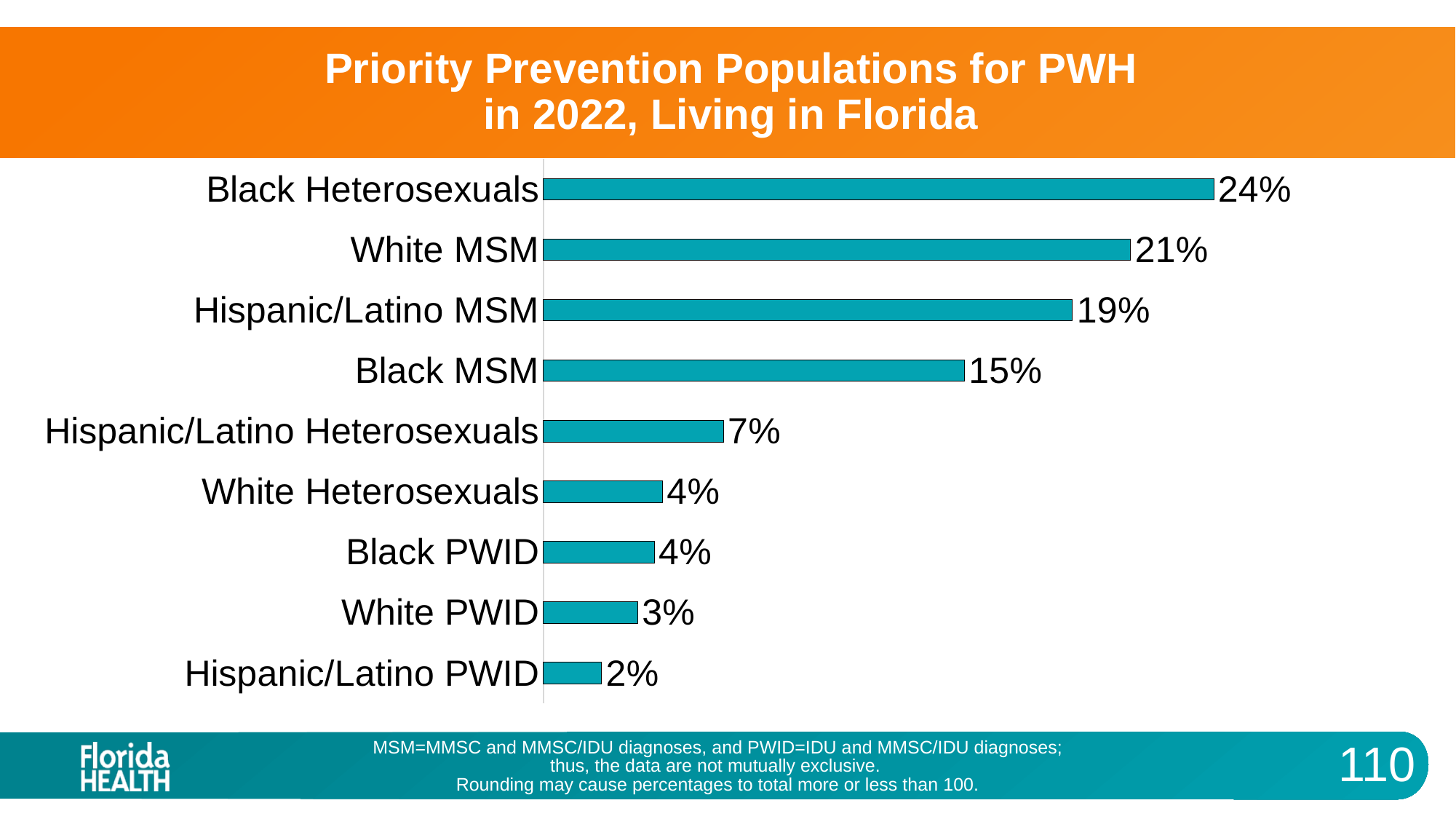
What percentage is shown for Black Heterosexuals? 24% What percentage is shown for White PWID? 3% Which population has the highest percentage? Black Heterosexuals What percentage is shown for Hispanic/Latino MSM? 19% What is the difference between the percentages for Black Heterosexuals and Hispanic/Latino Heterosexuals? 17% How many populations are shown in the chart? 9 Which is larger, the percentage for Hispanic/Latino MSM or for Black MSM? Hispanic/Latino MSM What is the title of the chart? Priority Prevention Populations for PWH in 2022, Living in Florida What kind of chart is shown on the slide? Bar chart Which population has the lowest percentage? Hispanic/Latino PWID What is the difference between the percentages for White MSM and Black MSM? 6% Which is larger, the percentage for Hispanic/Latino Heterosexuals or for White Heterosexuals? Hispanic/Latino Heterosexuals